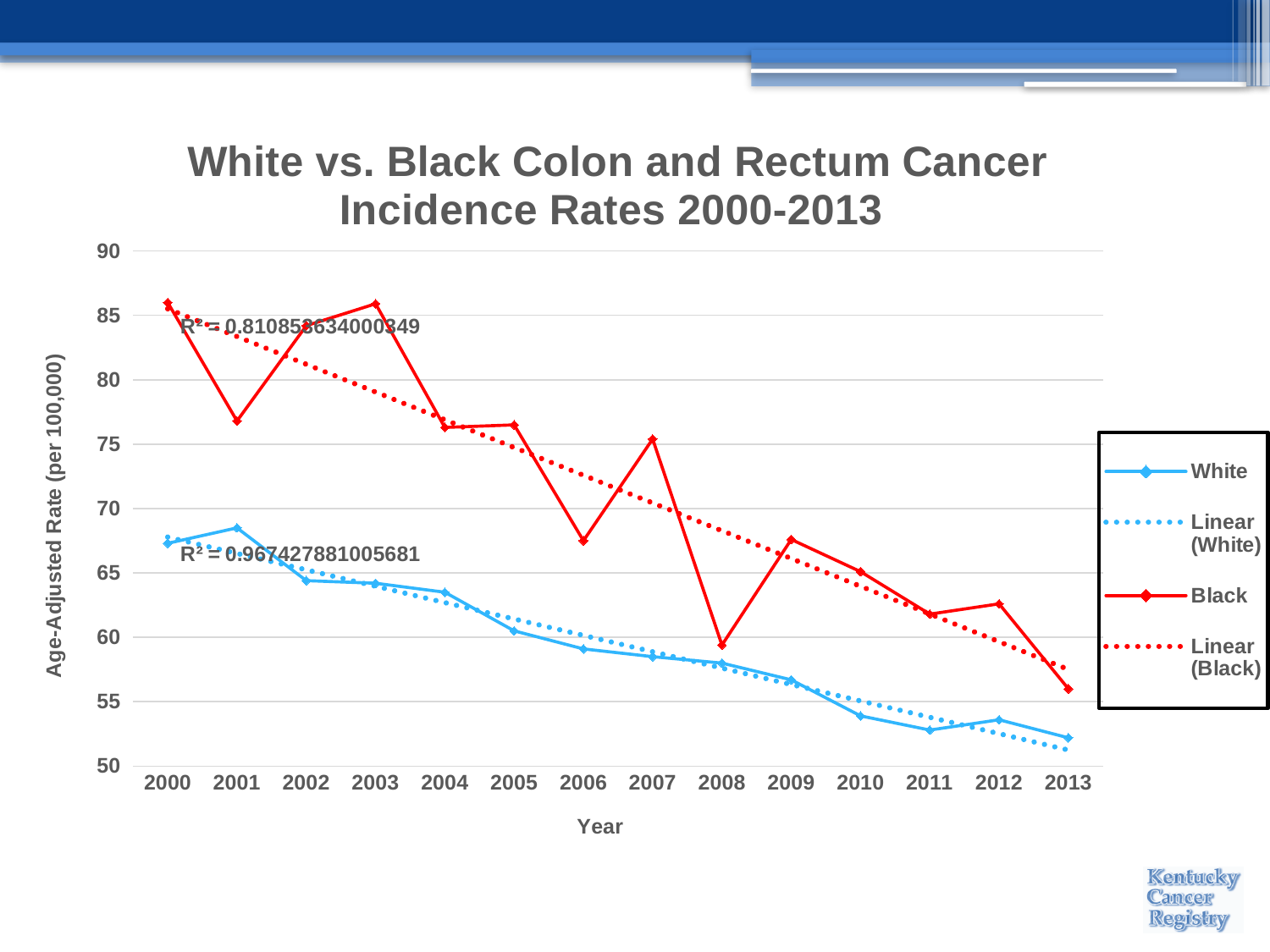
How many entries does the legend list? 4 In 2013, which series has the higher incidence rate, White or Black? Black Is the White incidence rate in 2000 greater or less than 65? greater How many years are plotted along the x axis? 14 Is the Black incidence rate in 2006 greater or less than 70? less Do the White incidence rates generally rise or fall from 2000 to 2013? fall What kind of chart is shown on the slide? line chart What is the label on the y axis of the chart? Age-Adjusted Rate (per 100,000) For the Black series, is the incidence rate higher in 2003 or in 2001? 2003 Which year has the lowest incidence rate for the Black series? 2013 Is the White incidence rate in 2010 greater or less than 55? less